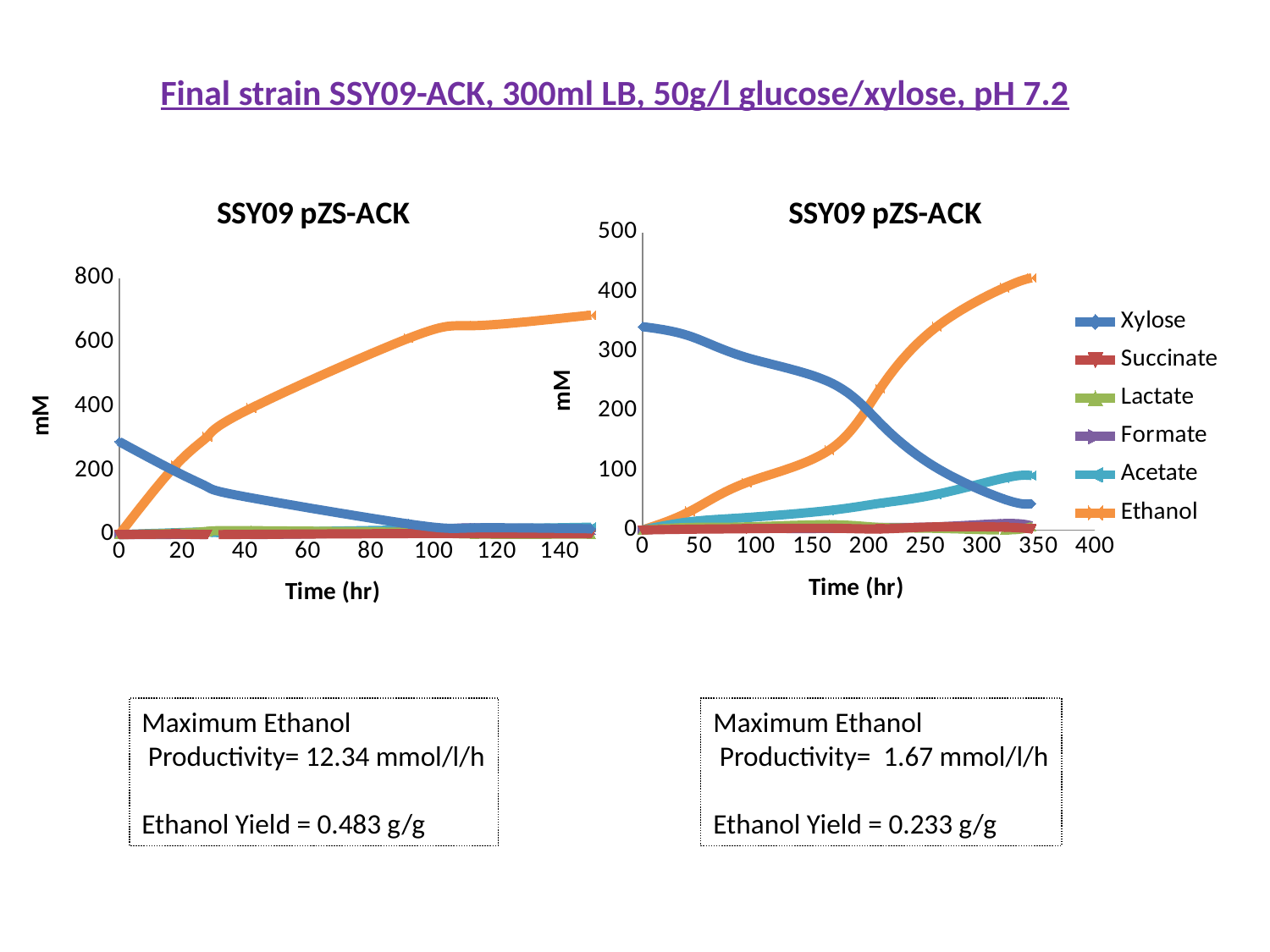
In the right chart, at the final time point, which is larger: Ethanol or Xylose? Ethanol What kind of chart is the left chart titled SSY09 pZS-ACK? line chart How many series does the legend on the slide list? 6 In the left chart, does the Ethanol series rise or fall over time? rise In the right chart, is the Ethanol value at the final time point greater or less than 300 mM? greater What colour is the Ethanol series in the legend? orange What is the y-axis label on the left chart? mM In the right chart, is the Xylose value at time 0 greater or less than 200 mM? greater In the right chart, does the Acetate series rise or fall over time? rise In the left chart, is the Ethanol value at the final time point greater or less than 600 mM? greater